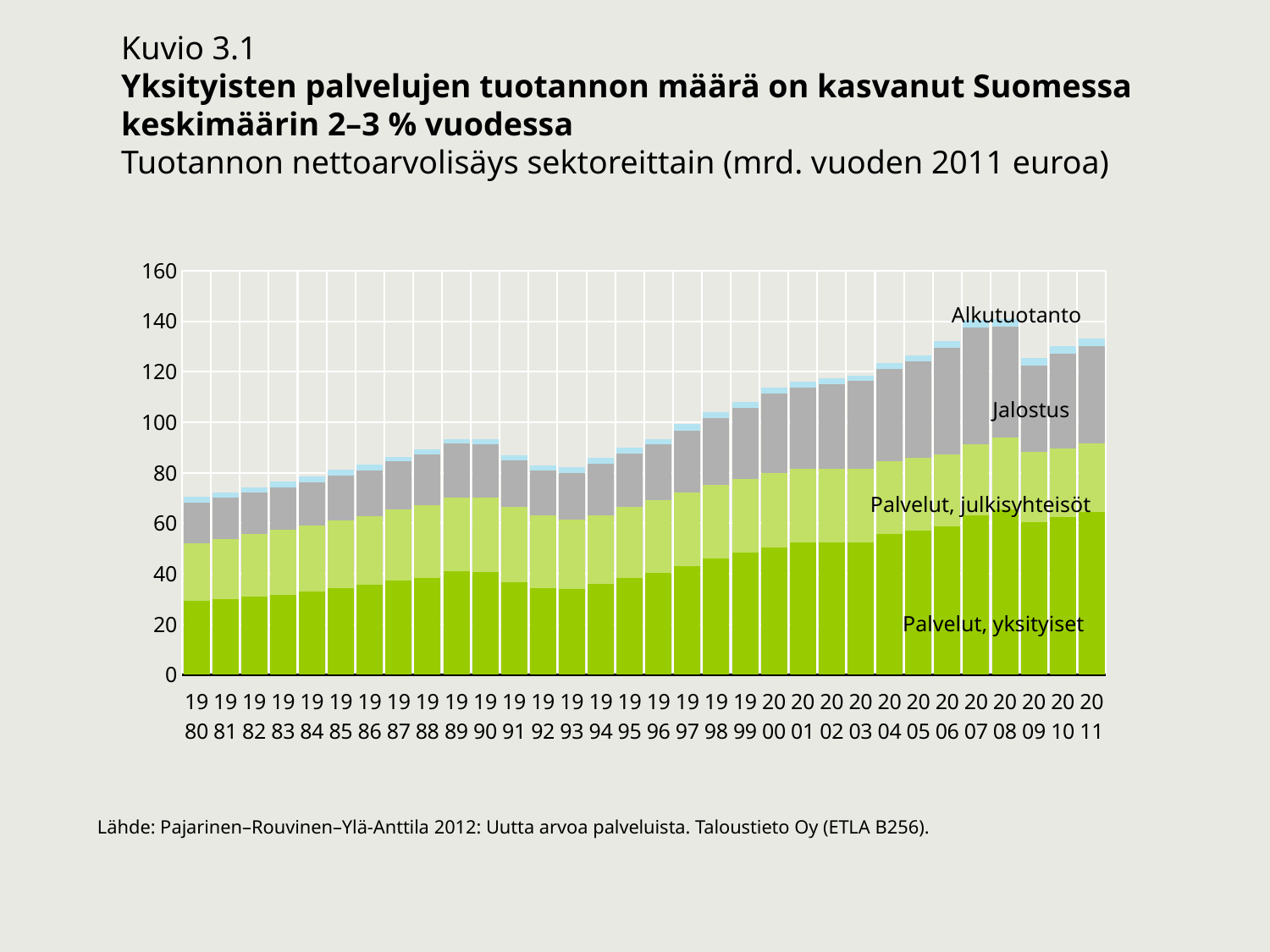
Is the total value of the bar for 2007 greater or less than 120? greater Which year has the larger total bar, 2009 or 2011? 2011 How many years (bars) are plotted on the x axis? 32 Which sector forms the bottom (dark green) segment of each bar? Palvelut, yksityiset Is the total value of the bar for 1980 greater or less than 80? less What kind of chart is shown on the slide? Stacked bar chart Is the Palvelut, yksityiset segment for 1980 greater or less than 40? less Which sector forms the top (light blue) segment of each bar? Alkutuotanto Which year has the lowest total bar? 1980 How many sectors (series) are stacked in each bar? 4